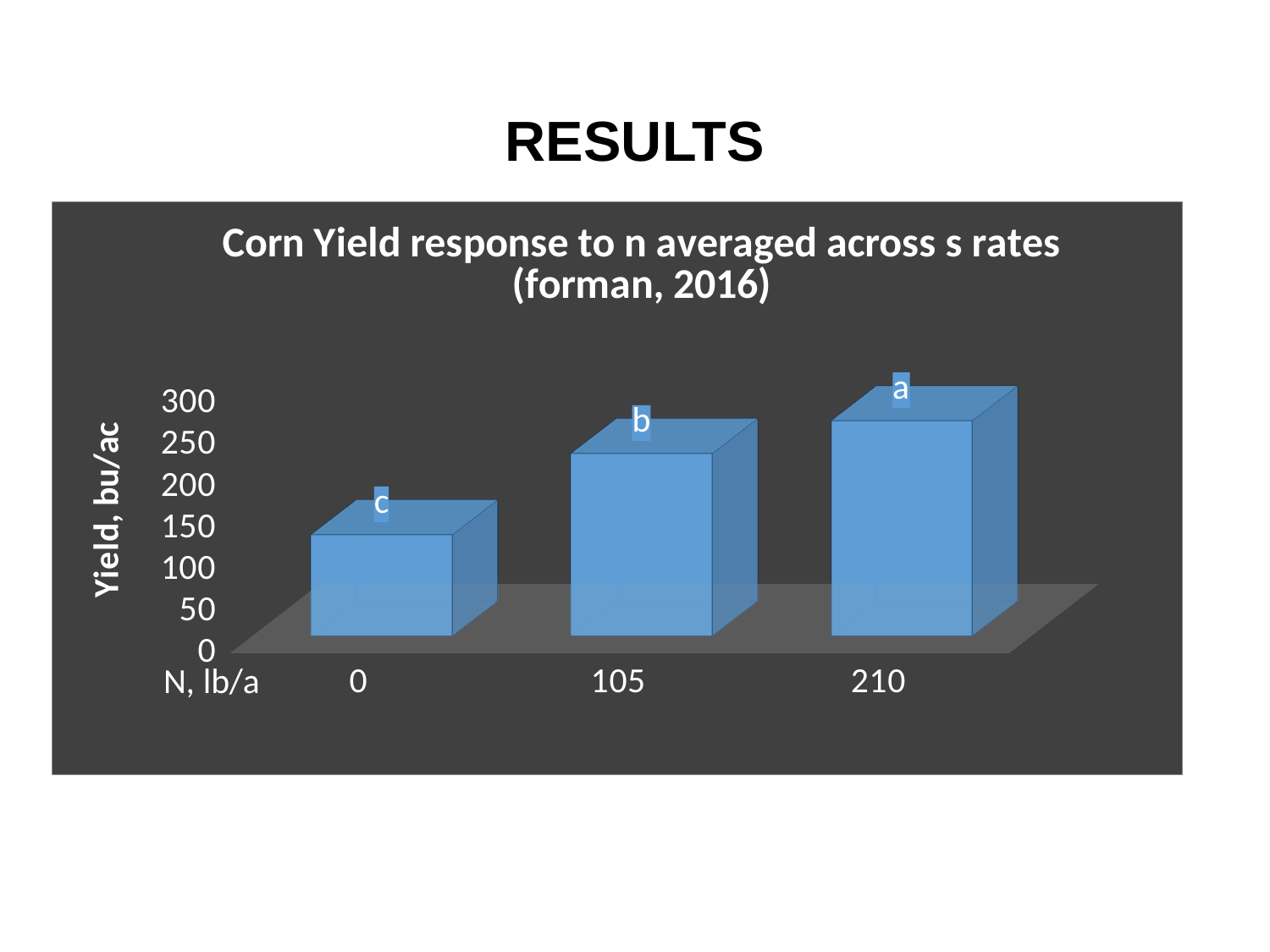
Which N rate (lb/a) has the lowest corn yield? 0 Is the yield for the 105 lb/a N rate greater or less than 200 bu/ac? greater Which N rate (lb/a) has the highest corn yield? 210 Which has the larger yield: the 105 lb/a N rate or the 0 lb/a N rate? 105 Do the yield values rise or fall as the N rate increases along the x axis? rise What letter label is shown above the bar for the 210 lb/a N rate? a What kind of chart is shown on the slide? bar chart Is the yield for the 0 lb/a N rate greater or less than 200 bu/ac? less What is the label on the y axis of the chart? Yield, bu/ac Is the yield for the 0 lb/a N rate greater or less than 100 bu/ac? greater How many bars (N rate categories) are plotted in the chart? 3